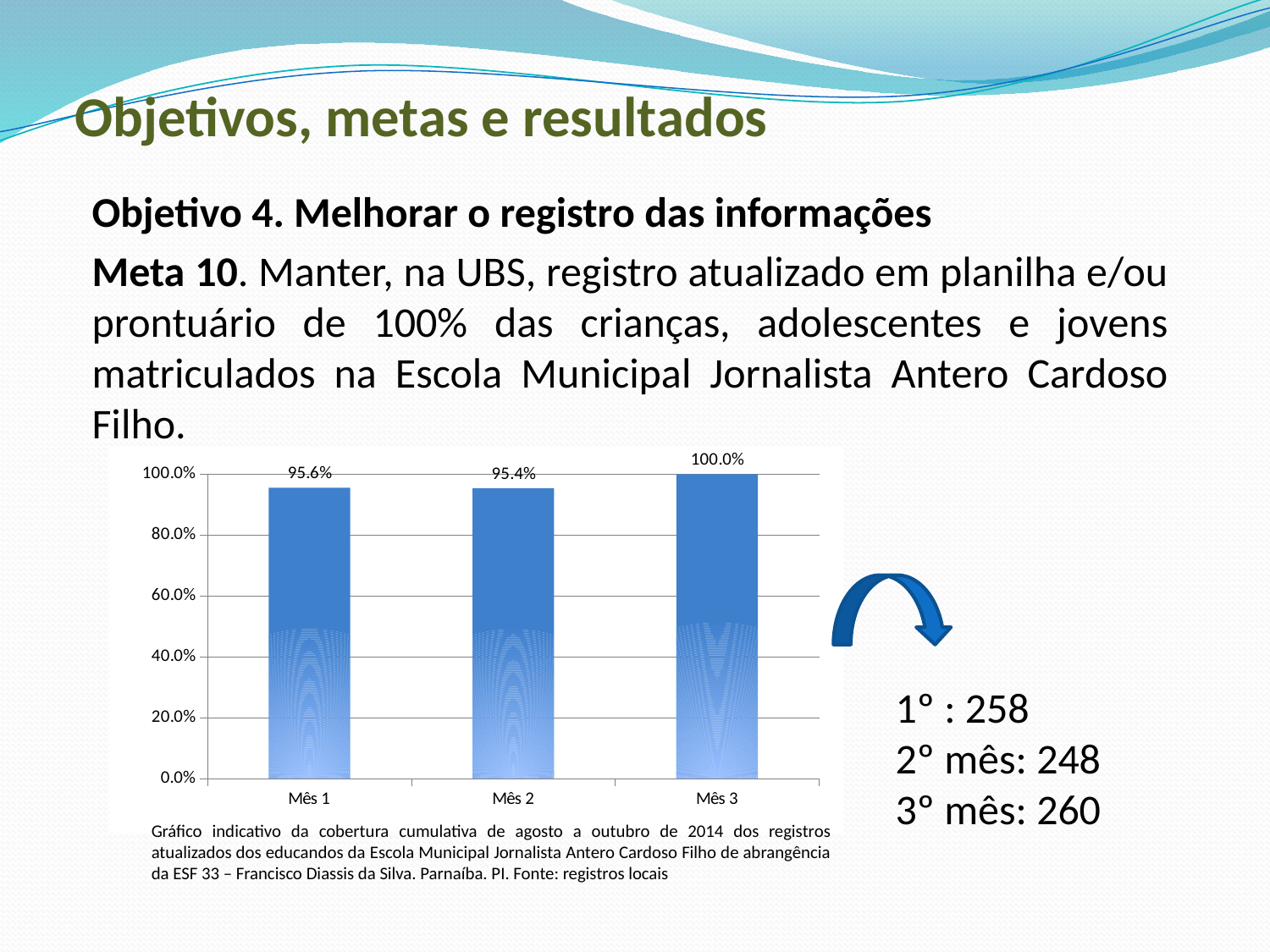
Does the value rise or fall from Mês 2 to Mês 3? rise Which month has the highest value in the chart? Mês 3 What kind of chart is shown on the slide? bar chart What is the value shown for Mês 3? 100.0% Is the value for Mês 2 greater or less than 80.0%? greater What is the difference between the values for Mês 3 and Mês 2? 4.6% What is the highest tick value shown on the vertical axis of the chart? 100.0% What is the difference between the values for Mês 3 and Mês 1? 4.4% How many bars are plotted in the chart? 3 What is the value shown for Mês 2? 95.4% Which is larger, the value for Mês 3 or the value for Mês 1? Mês 3 What is the value shown for Mês 1? 95.6%